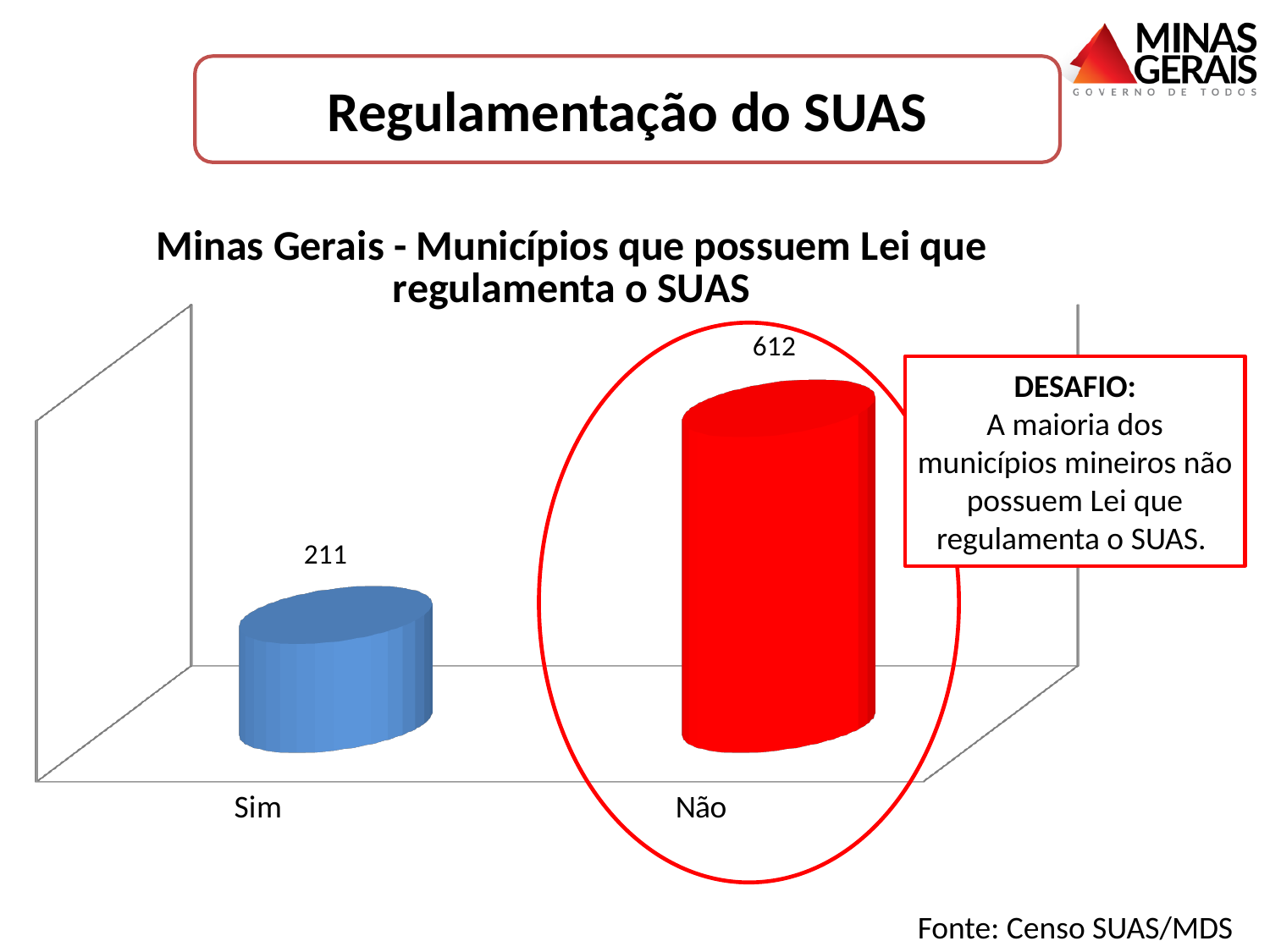
Which category has the highest value? Não Which category has the lowest value? Sim What is the title of the chart? Minas Gerais - Municípios que possuem Lei que regulamenta o SUAS What kind of chart is shown on the slide? Bar chart How many categories are shown in the chart? 2 Which is larger, the value for "Sim" or the value for "Não"? Não What is the value for "Sim"? 211 What is the difference between the values for "Não" and "Sim"? 401 What is the value for "Não"? 612 What is the total of the two values shown in the chart? 823 What colour is the bar for "Não"? Red